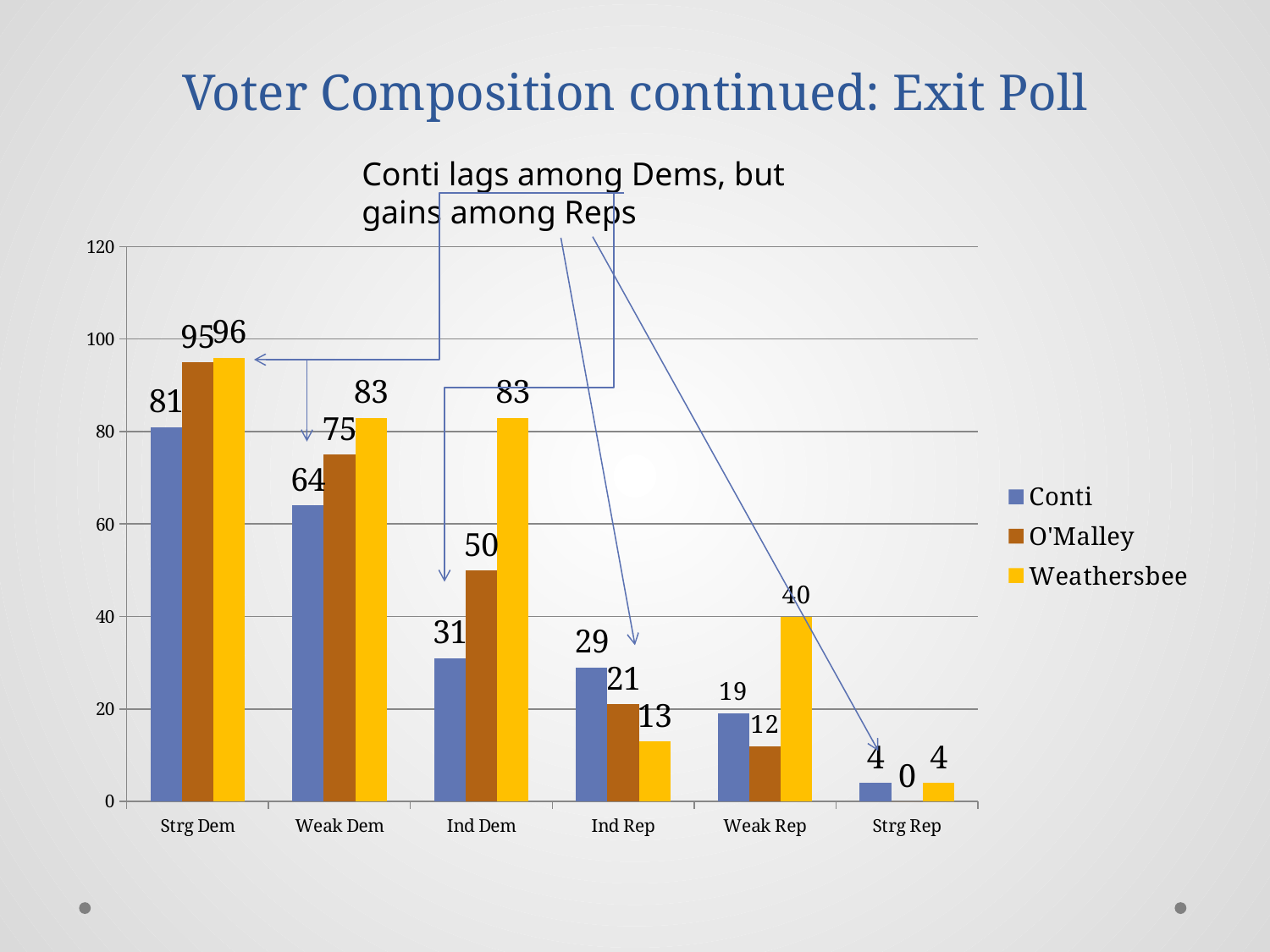
What is the value for Weathersbee in the Ind Dem category? 83 Is the value for O'Malley in the Ind Dem category greater or less than 40? greater Which category has the highest value for Conti? Strg Dem How many series does the legend list? 3 How many categories are shown on the x axis? 6 In the Ind Rep category, which is larger: the value for Conti or the value for Weathersbee? Conti Which category has the lowest value for O'Malley? Strg Rep What is the value for O'Malley in the Weak Rep category? 12 Do the values for Conti rise or fall from Strg Dem to Strg Rep along the x axis? fall What is the difference between the Weathersbee and Conti values in the Weak Rep category? 21 What kind of chart is shown on the slide? bar chart What is the value for Conti in the Strg Dem category? 81